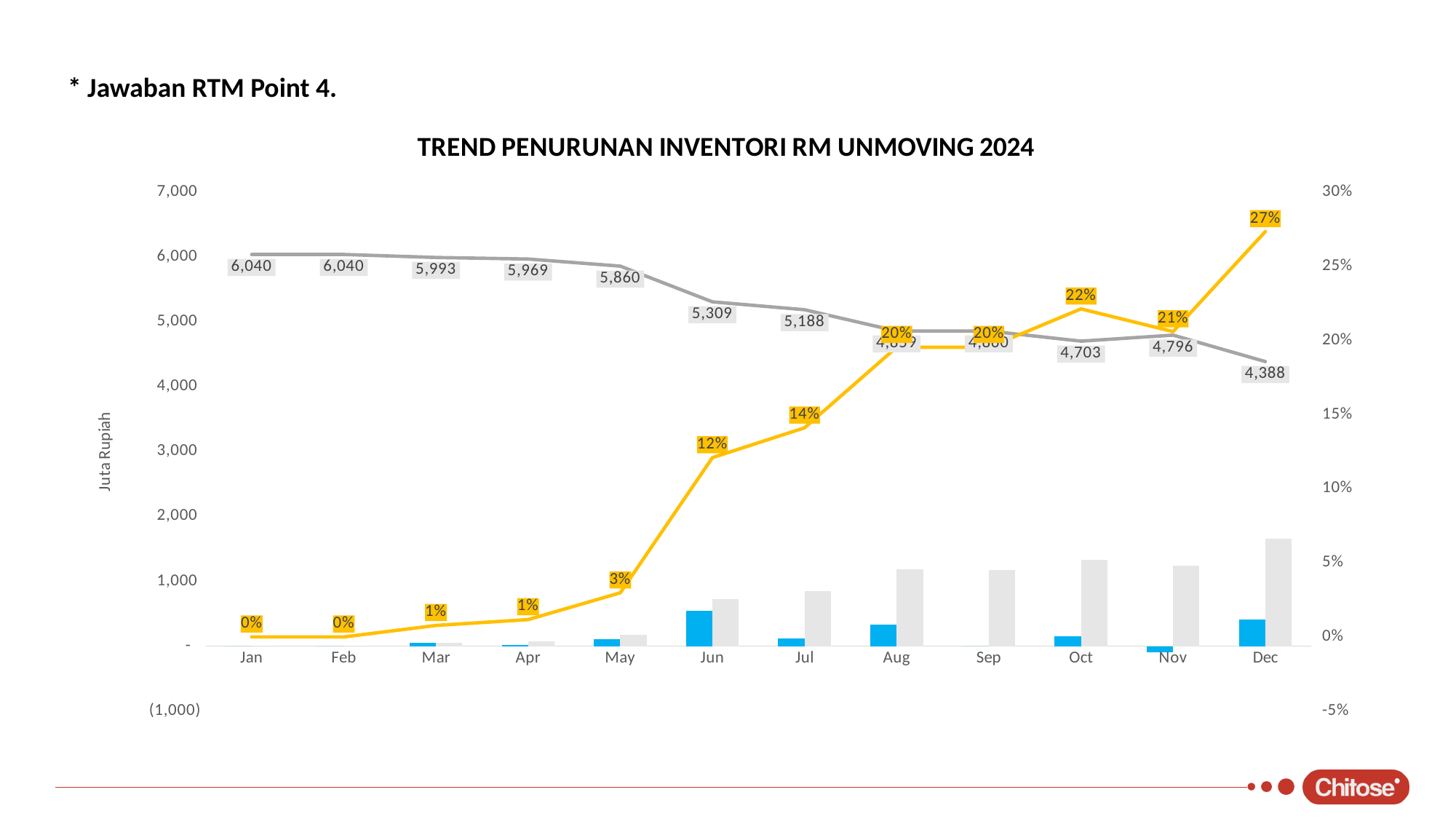
What is the title of the chart? TREND PENURUNAN INVENTORI RM UNMOVING 2024 Which is larger, the grey line value for Oct or for Nov? Nov How many months are shown on the x axis? 12 What percentage does the yellow line show for Jun? 12% What percentage does the yellow line show for Oct? 22% What is the value of the grey line for Jan? 6,040 In which month does the yellow percentage line reach its highest value? Dec What is the difference between the grey line values for Jan and Dec? 1,652 Is the value of the grey line for Jul greater or less than 5,000? greater Does the grey line generally rise or fall from Jan to Dec? fall In which month is the grey line at its lowest value? Dec What is the value of the grey line for Dec? 4,388